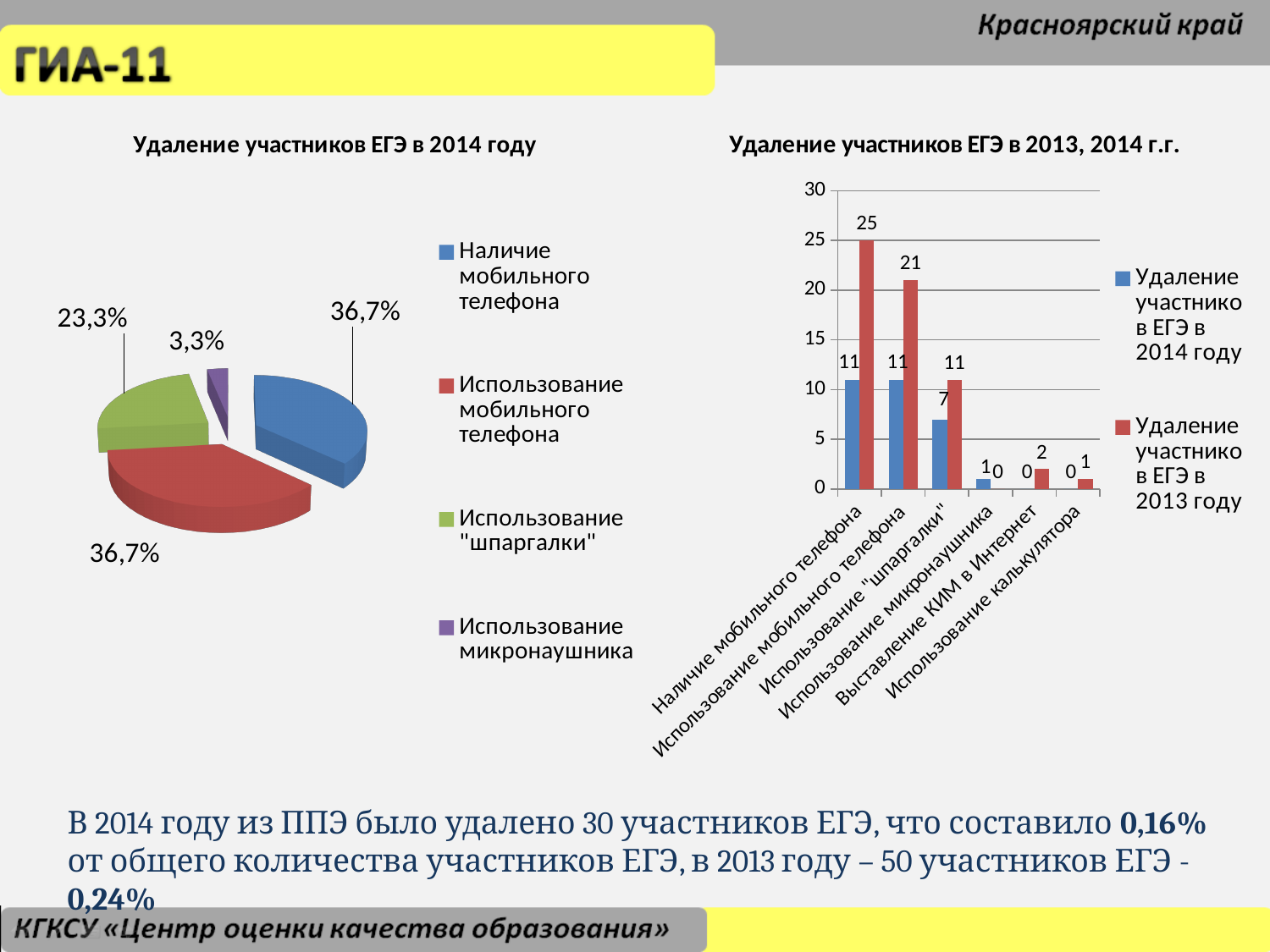
On the bar chart 'Удаление участников ЕГЭ в 2013, 2014 г.г.', what is the value for 'Использование "шпаргалки"' in 2014? 7 On the bar chart 'Удаление участников ЕГЭ в 2013, 2014 г.г.', which is larger for 'Выставление КИМ в Интернет': the 2013 value or the 2014 value? 2013 On the bar chart 'Удаление участников ЕГЭ в 2013, 2014 г.г.', how many categories are shown on the x axis? 6 On the pie chart 'Удаление участников ЕГЭ в 2014 году', what share is shown for 'Использование "шпаргалки"'? 23,3% On the bar chart 'Удаление участников ЕГЭ в 2013, 2014 г.г.', what is the value for 'Наличие мобильного телефона' in 2013? 25 What type of chart is 'Удаление участников ЕГЭ в 2014 году'? Pie chart On the bar chart 'Удаление участников ЕГЭ в 2013, 2014 г.г.', what is the difference between the 2013 and 2014 values for 'Использование мобильного телефона'? 10 On the pie chart 'Удаление участников ЕГЭ в 2014 году', what share is shown for 'Использование микронаушника'? 3,3% On the bar chart 'Удаление участников ЕГЭ в 2013, 2014 г.г.', which category has the highest value in 2013? Наличие мобильного телефона On the pie chart 'Удаление участников ЕГЭ в 2014 году', which category has the smallest share? Использование микронаушника On the bar chart 'Удаление участников ЕГЭ в 2013, 2014 г.г.', how many series does the legend list? 2 On the pie chart 'Удаление участников ЕГЭ в 2014 году', how many slices are there? 4